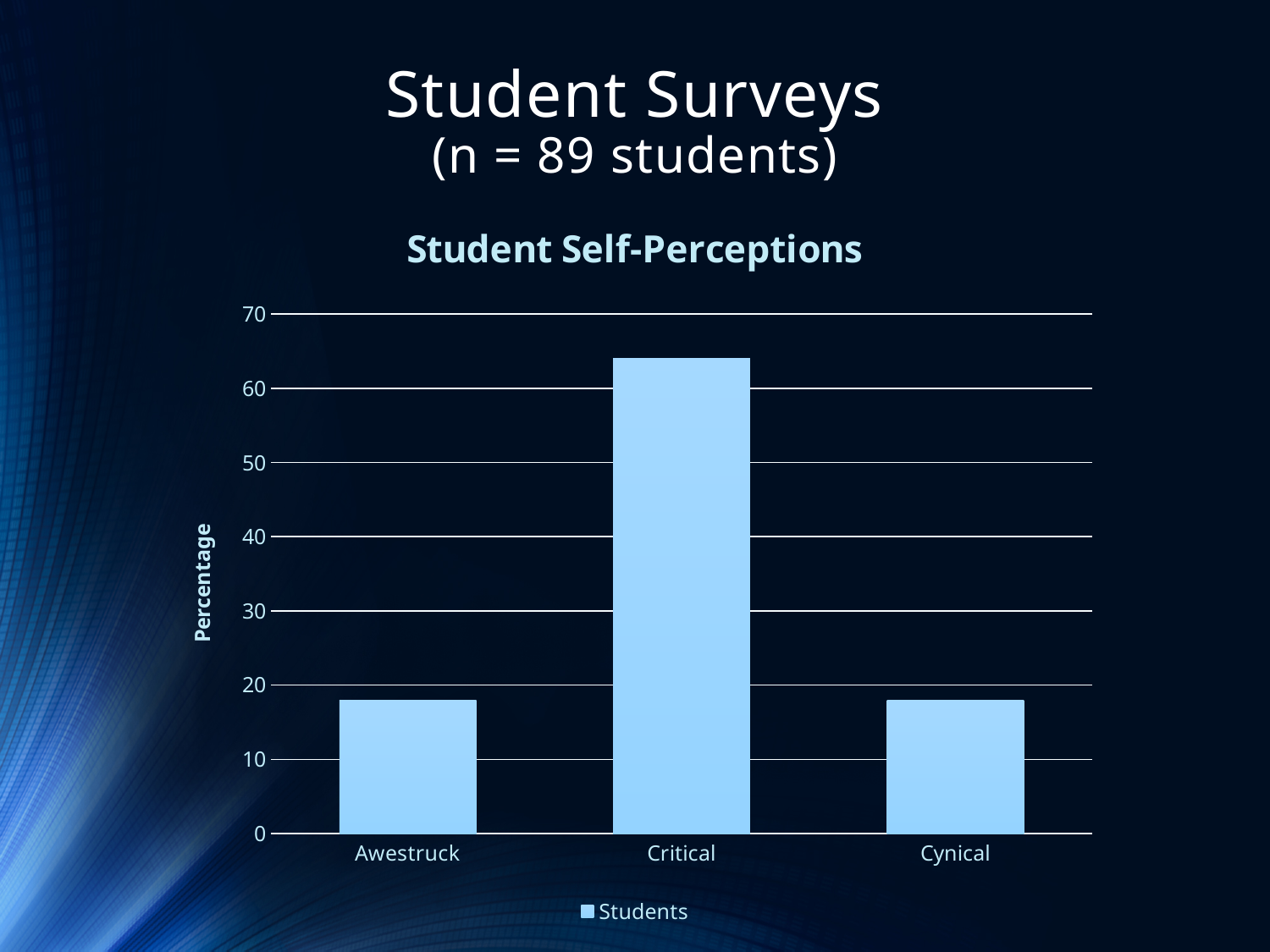
Which category has the highest value in the Student Self-Perceptions chart? Critical Is the value for Critical greater or less than 60? greater How many series does the legend list? 1 How many categories are shown on the x axis of the chart? 3 What kind of chart is shown on the slide? bar chart Is the value for Awestruck greater or less than 20? less Is the value for Cynical greater or less than 20? less What is the label on the vertical axis of the chart? Percentage What is the title of the chart? Student Self-Perceptions Which is larger, the value for Critical or the value for Awestruck? Critical